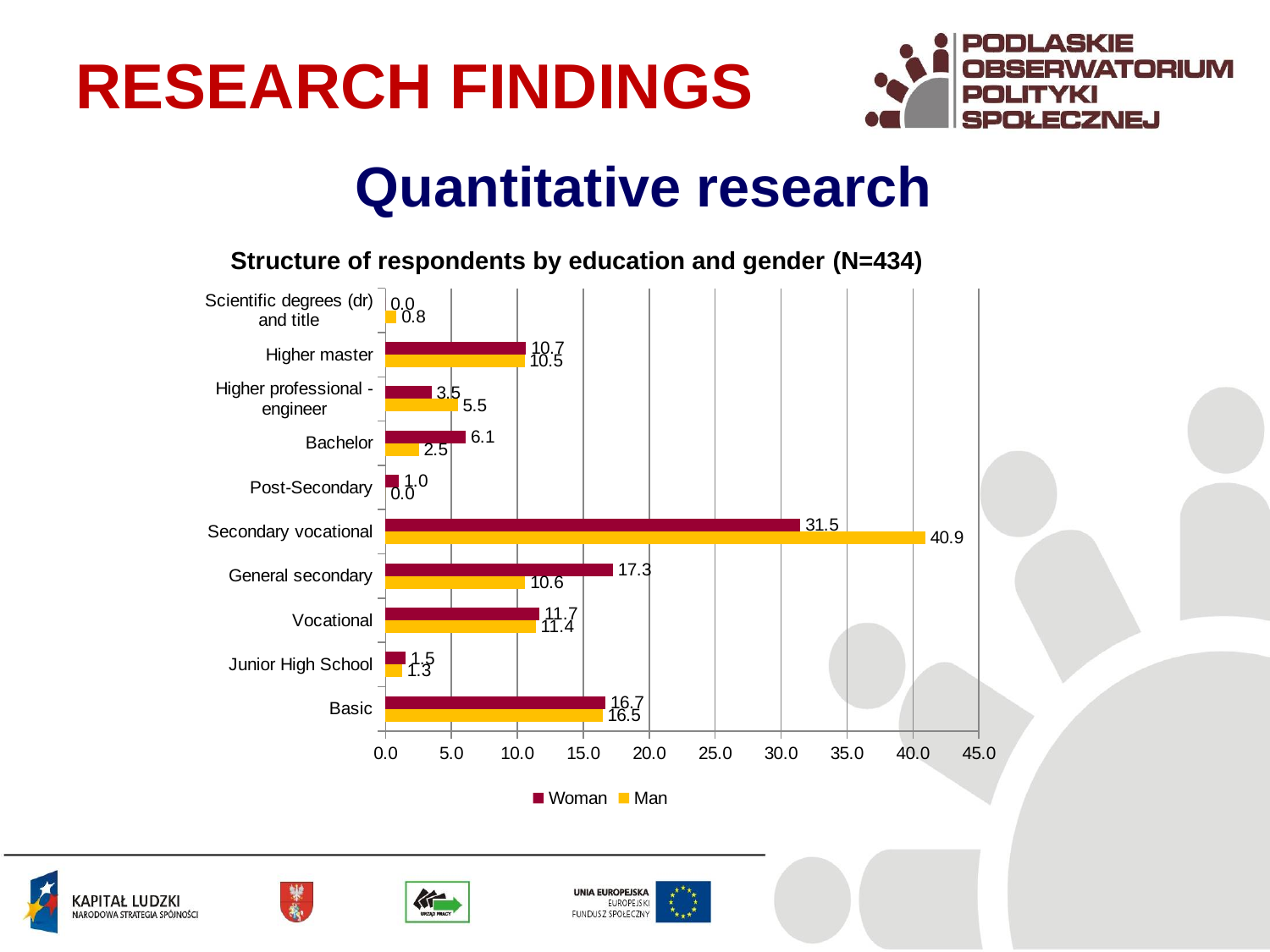
What is the value for Man in the Bachelor category? 2.5 What is the difference between the Woman and Man values in the General secondary category? 6.7 What is the value for Man in the Secondary vocational category? 40.9 What is the value for Woman in the Higher professional - engineer category? 3.5 Which education category has the lowest value for Woman? Scientific degrees (dr) and title What kind of chart is shown on the slide? Bar chart Which education category has the highest value for Man? Secondary vocational How many education categories are shown on the chart? 10 What is the difference between the Man and Woman values in the Secondary vocational category? 9.4 How many series does the legend list? 2 What is the value for Woman in the Secondary vocational category? 31.5 In the General secondary category, which is larger, the Woman value or the Man value? Woman